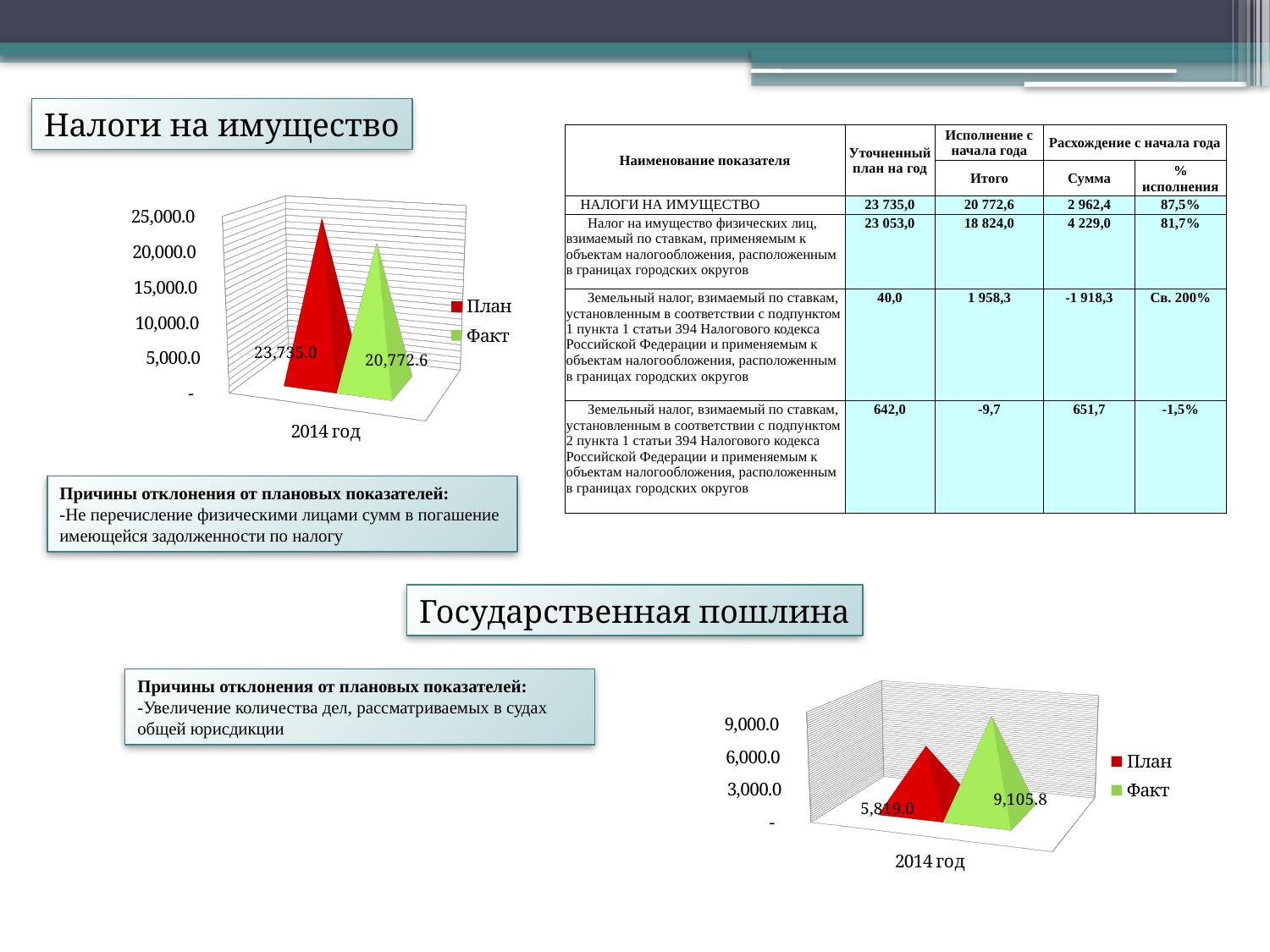
In the chart under "Государственная пошлина", what is the value for План? 5,819.0 In the chart under "Государственная пошлина", what is the value for Факт? 9,105.8 In the chart under "Налоги на имущество", what is the value for Факт? 20,772.6 What kind of chart is shown under "Государственная пошлина"? bar chart In the chart under "Налоги на имущество", what is the value for План? 23,735.0 In the chart under "Налоги на имущество", what category is shown on the x axis? 2014 год In the chart under "Налоги на имущество", which series is larger, План or Факт? План In the chart under "Государственная пошлина", is the value for Факт greater or less than 6,000.0? greater In the chart under "Государственная пошлина", what is the difference between Факт and План? 3,286.8 In the chart under "Налоги на имущество", what is the difference between План and Факт? 2,962.4 In the chart under "Налоги на имущество", how many series does the legend list? 2 In the chart under "Государственная пошлина", which series is larger, План or Факт? Факт